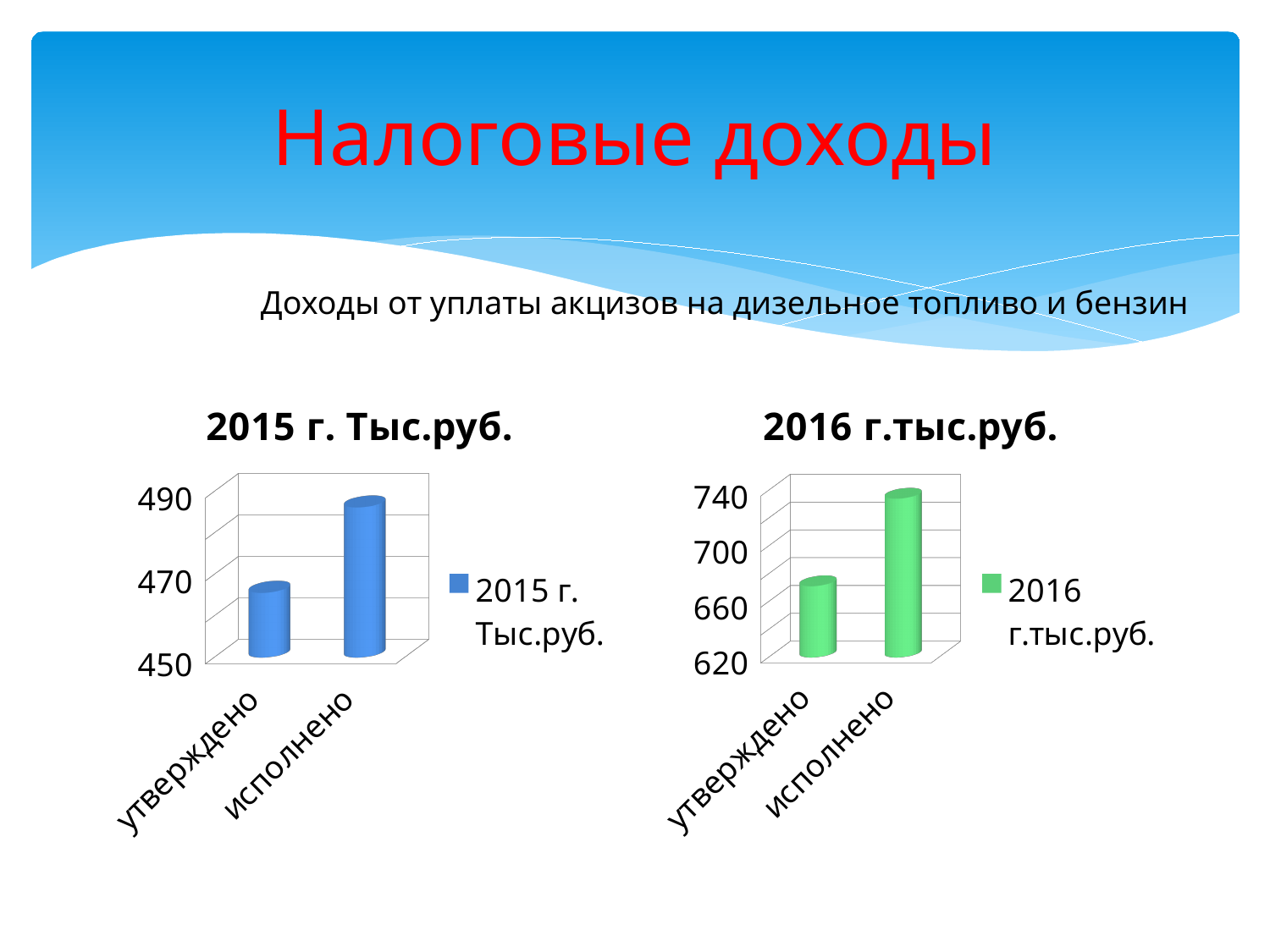
In the "2016 г.тыс.руб." chart, is the value for исполнено greater or less than 700? greater What is the legend entry of the chart on the right? 2016 г.тыс.руб. What kind of chart is the "2015 г. Тыс.руб." chart? bar chart In the "2015 г. Тыс.руб." chart, is the value for исполнено greater or less than 470? greater In the "2016 г.тыс.руб." chart, is the value for утверждено greater or less than 700? less In the "2016 г.тыс.руб." chart, which category has the lowest value? утверждено How many categories are shown on the x axis of the "2016 г.тыс.руб." chart? 2 In the "2015 г. Тыс.руб." chart, which category has the highest value? исполнено How many series does the legend of the "2015 г. Тыс.руб." chart list? 1 What colour are the bars in the "2015 г. Тыс.руб." chart? blue In the "2015 г. Тыс.руб." chart, which is larger: утверждено or исполнено? исполнено